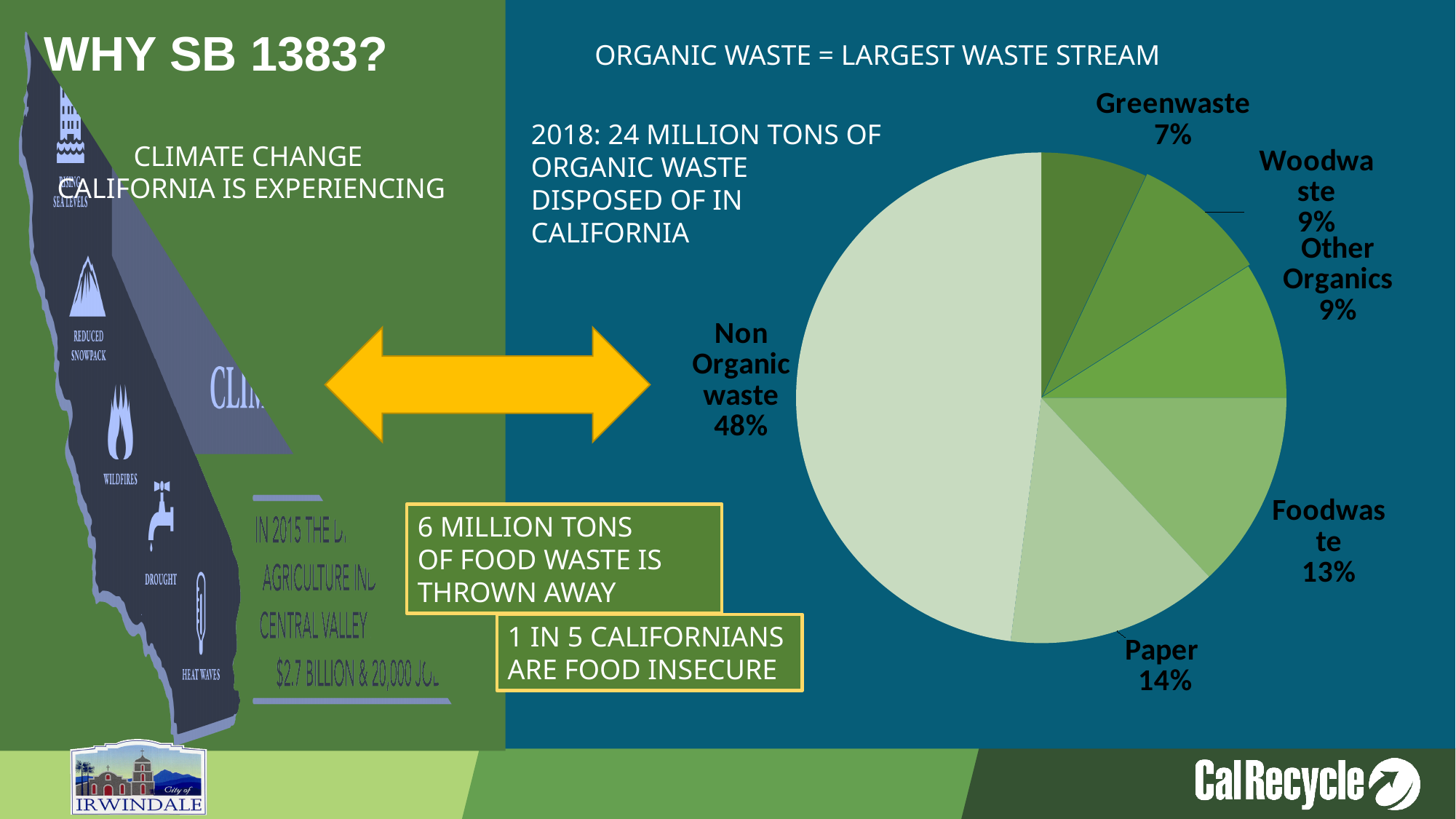
What is the title shown above the pie chart? ORGANIC WASTE = LARGEST WASTE STREAM Which slice of the pie is the largest? Non Organic waste What percentage does the Foodwaste slice show? 13% What kind of chart is shown on the slide? pie chart What percentage does the Paper slice show? 14% What percentage does the Woodwaste slice show? 9% Which slice of the pie is the smallest? Greenwaste What percentage does the Greenwaste slice show? 7% Which is larger, the Foodwaste slice or the Greenwaste slice? Foodwaste How many slices does the pie chart have? 6 What share of the pie is Non Organic waste? 48% What is the difference in percentage points between Paper and Foodwaste? 1%